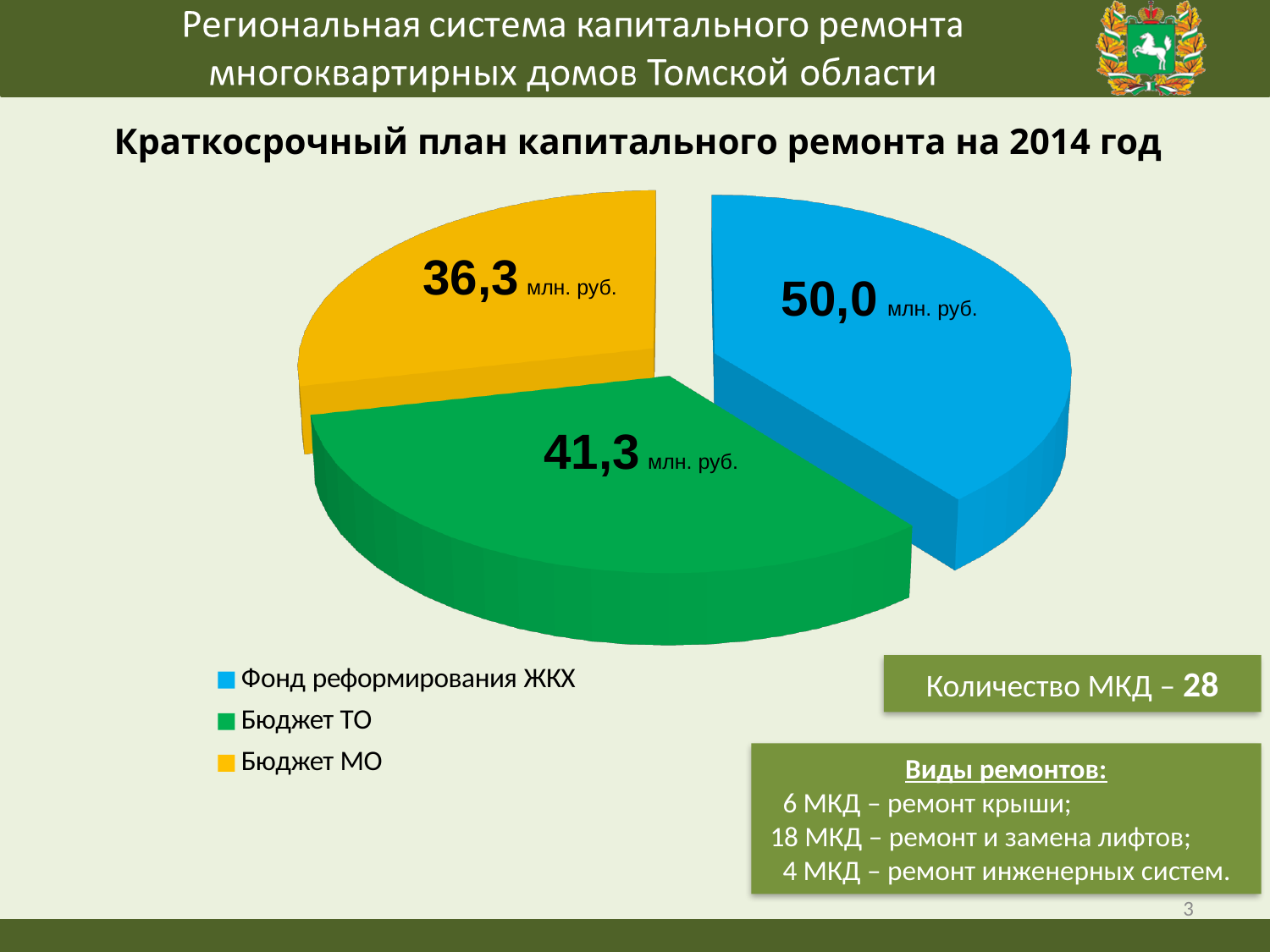
What type of chart is shown on the slide? Pie chart What is the value for Бюджет МО? 36,3 млн. руб. How many slices does the pie chart have? 3 What is the value for Фонд реформирования ЖКХ? 50,0 млн. руб. What is the total of all three slices of the pie chart? 127,6 млн. руб. Which colour represents Бюджет ТО in the pie chart? Green What is the difference between the values for Бюджет ТО and Бюджет МО? 5,0 млн. руб. Which category has the smallest slice of the pie? Бюджет МО What is the difference between the values for Фонд реформирования ЖКХ and Бюджет ТО? 8,7 млн. руб. Which category has the largest slice of the pie? Фонд реформирования ЖКХ What is the value for Бюджет ТО? 41,3 млн. руб. Which is larger, the value for Бюджет ТО or the value for Бюджет МО? Бюджет ТО